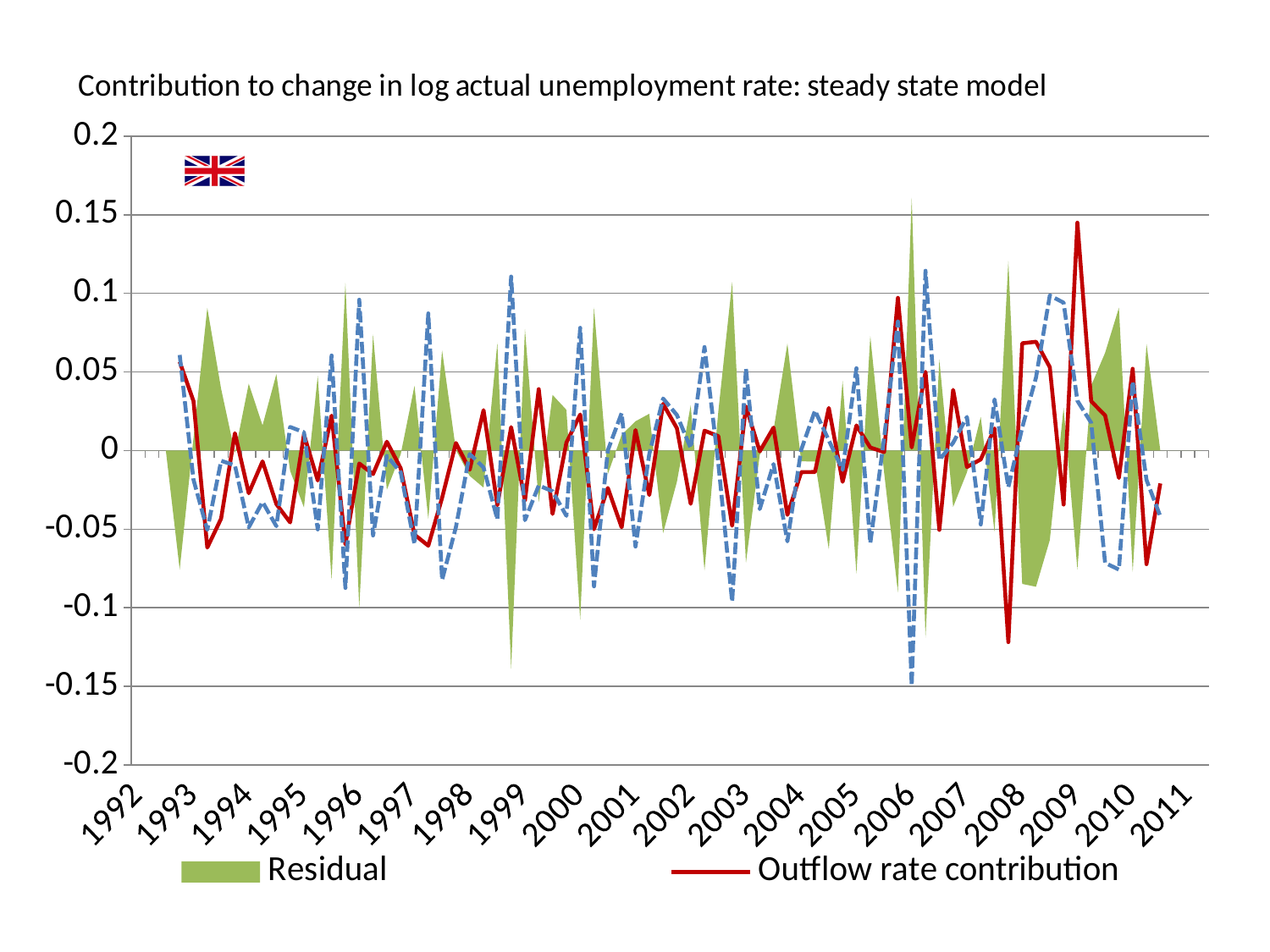
What kind of chart is shown on the slide? Line chart with a shaded area series How many series does the legend list? 2 How many year labels are shown on the horizontal axis? 20 What is the highest value shown on the vertical axis? 0.2 Is the peak value of the Outflow rate contribution in 2009 greater or less than 0.1? greater In which year does the Outflow rate contribution line reach its highest peak? 2009 Is the lowest Residual value around 1999 greater or less than -0.1? less Which series is drawn as a green shaded area? Residual What is the title of the chart? Contribution to change in log actual unemployment rate: steady state model